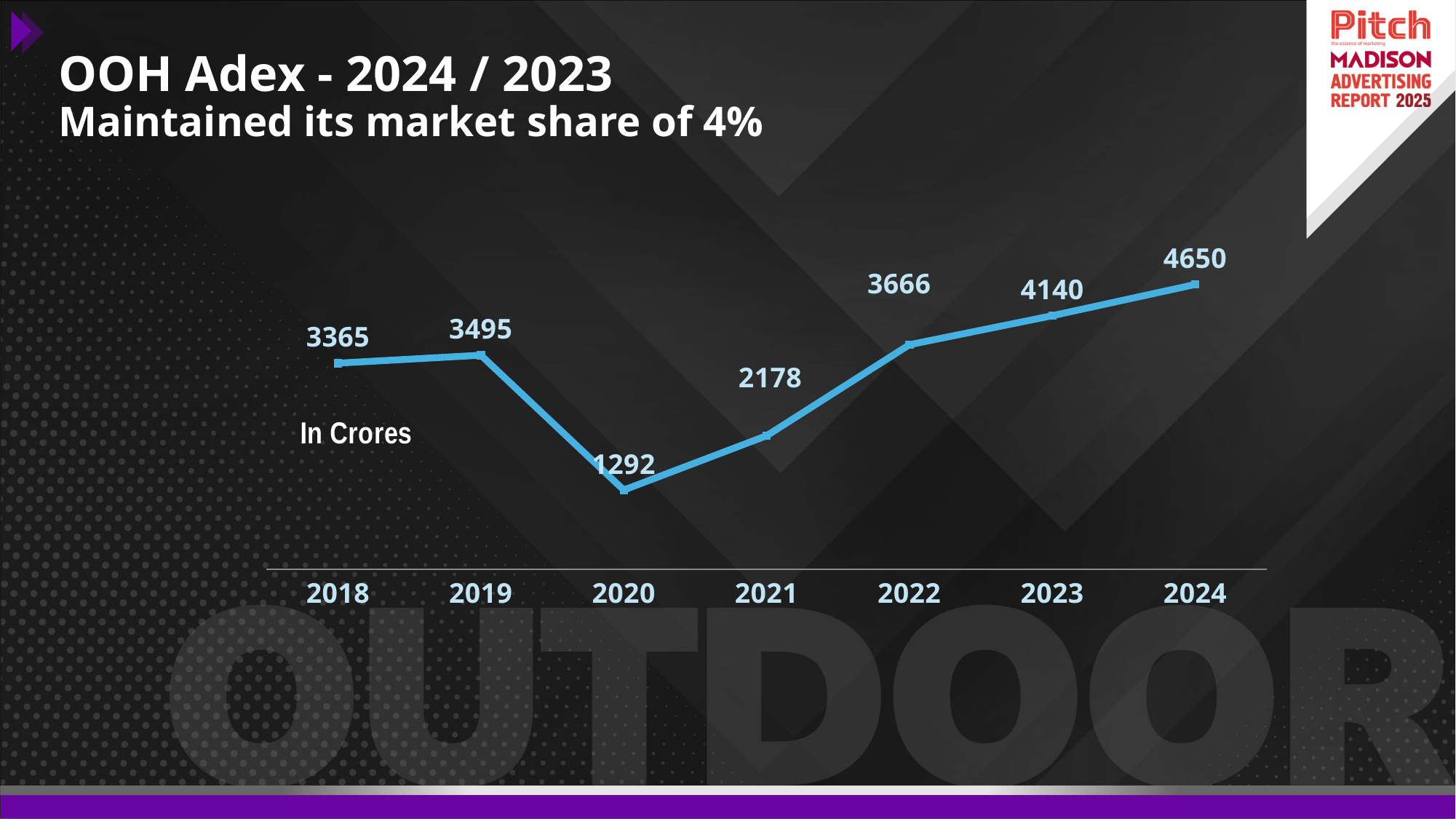
Do the OOH Adex values rise or fall from 2020 to 2024? Rise What is the difference between the OOH Adex values for 2019 and 2020? 2203 How many years are plotted on the chart? 7 Which year has the highest OOH Adex value? 2024 What is the OOH Adex value for 2021? 2178 What is the OOH Adex value for 2020? 1292 What kind of chart is shown on the slide? Line chart Which year has a larger OOH Adex value, 2018 or 2022? 2022 Which year has the lowest OOH Adex value? 2020 What is the difference between the OOH Adex values for 2024 and 2023? 510 What is the OOH Adex value for 2024? 4650 In what unit are the chart values expressed? In Crores